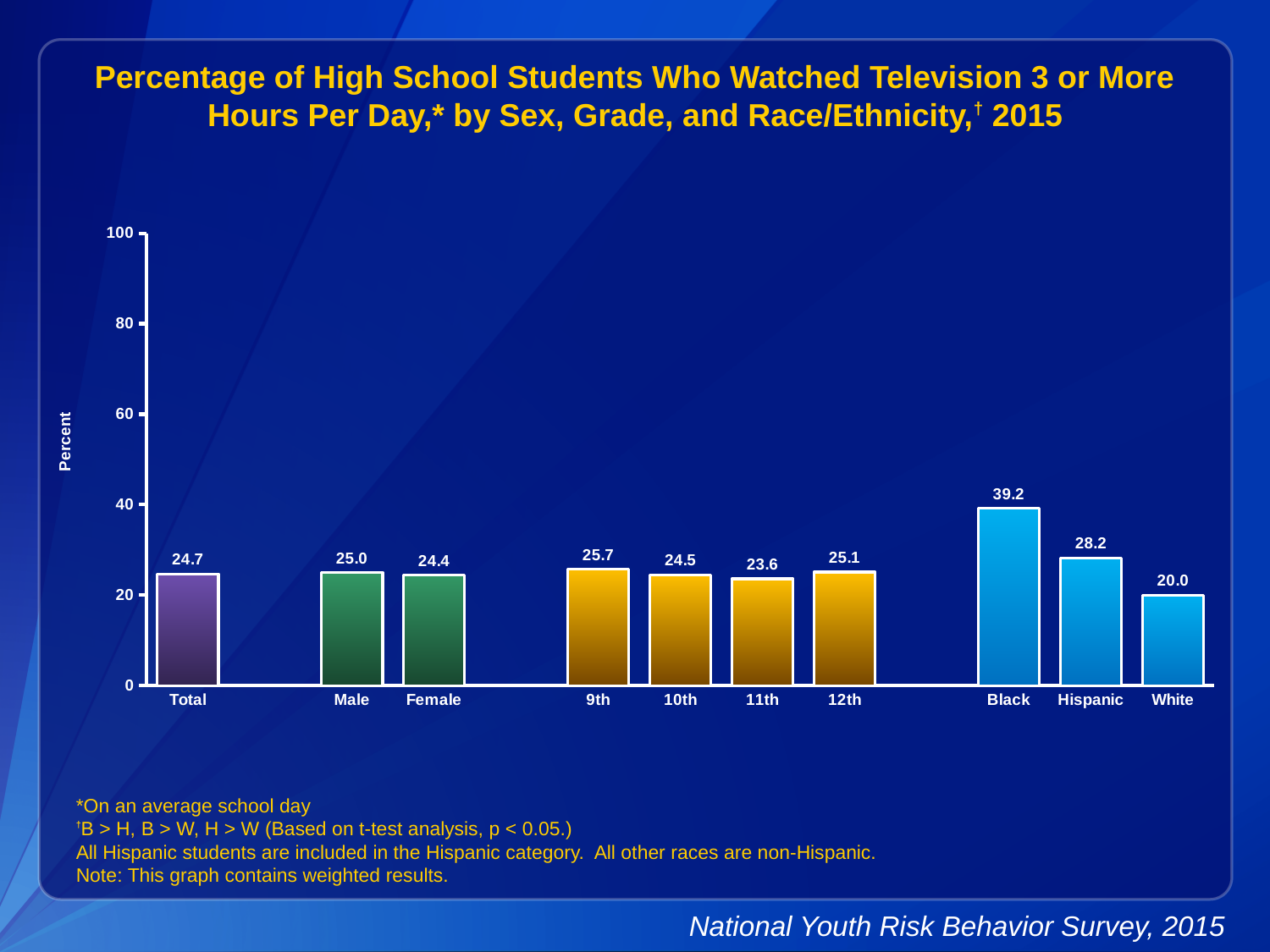
Which is larger, the value for Hispanic or the value for White? Hispanic What is the difference between the values for Male and Female? 0.6 What percentage of Black students watched television 3 or more hours per day? 39.2 Is the value for Black greater or less than 40? less What is the value for Total? 24.7 What is the label of the y axis? Percent What is the difference between the values for Black and White? 19.2 What is the value for 11th grade? 23.6 Which category has the lowest value? White Which category has the highest value? Black What kind of chart is shown on the slide? bar chart How many categories are shown on the x axis? 10